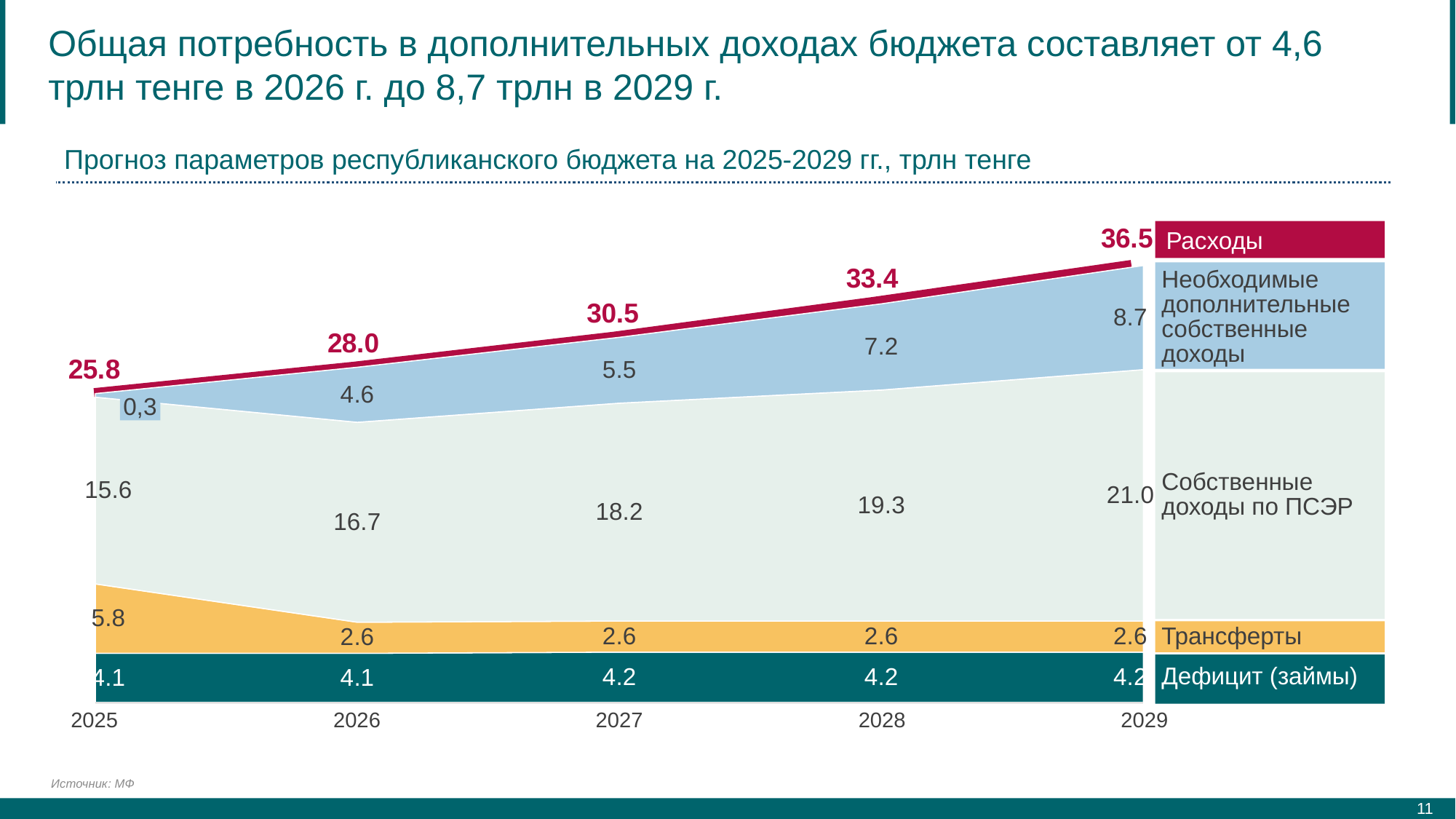
What is the value of Трансферты in 2025? 5.8 What is the difference between Расходы in 2029 and Расходы in 2025? 10.7 What is the value of Необходимые дополнительные собственные доходы in 2026? 4.6 What is the value of Расходы in 2027? 30.5 In which year is Расходы highest? 2029 In which year is Необходимые дополнительные собственные доходы lowest? 2025 Does Расходы rise or fall from 2025 to 2029? rise What kind of chart is this? area chart What is the value of Собственные доходы по ПСЭР in 2028? 19.3 How many years are shown on the x axis? 5 How many series does the legend list? 5 Which is larger: Собственные доходы по ПСЭР in 2026 or in 2027? 2027